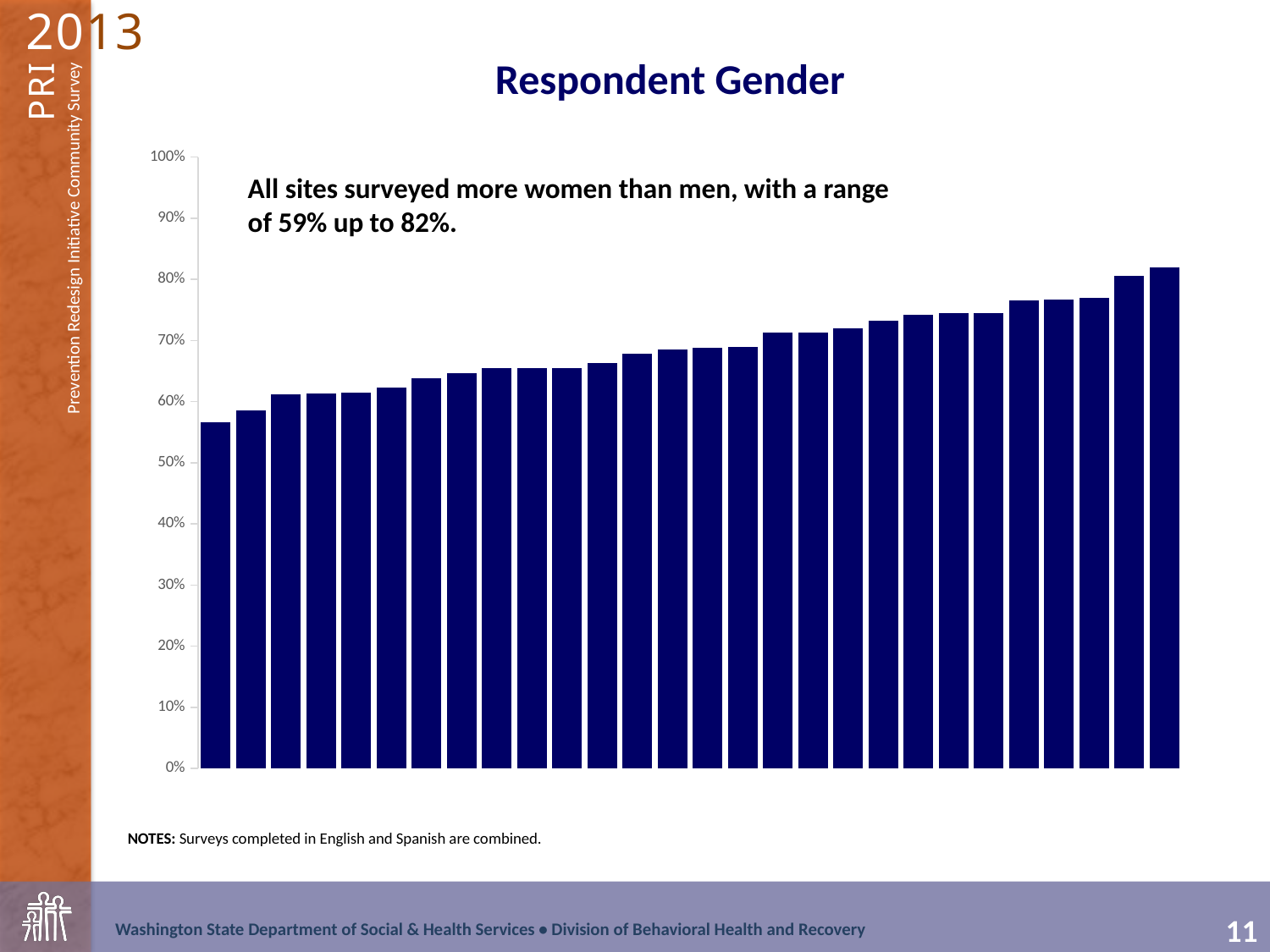
What kind of chart is shown on the slide? bar chart Which bar is the highest in the chart, the leftmost or the rightmost? rightmost Is the value of the rightmost bar greater or less than 80%? greater What is the title of the chart on the slide? Respondent Gender How many bars are plotted in the chart? 28 Is the value of the shortest bar greater or less than 50%? greater Which is larger, the value of the rightmost bar or the value of the leftmost bar? rightmost bar Do the bar values rise or fall from left to right across the chart? rise Which bar is the lowest in the chart, the leftmost or the rightmost? leftmost What is the maximum value shown on the vertical axis of the chart? 100% Is the value of the leftmost bar greater or less than 60%? less